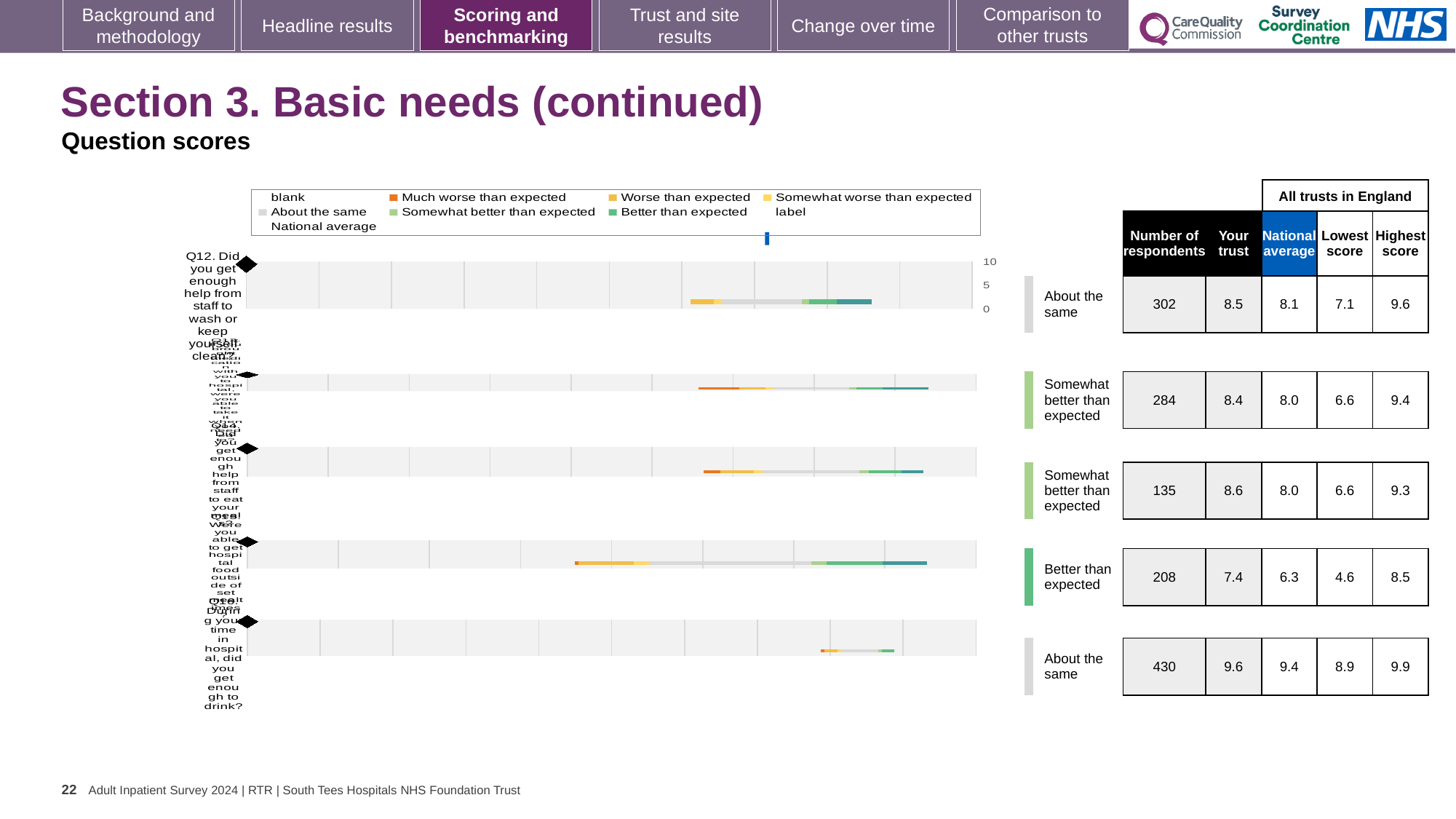
Which row has the lowest 'Your trust' score? the fourth row (Q15, hospital food outside of set meal times), 7.4 What kind of chart is used to show the question scores on this slide? bar chart How many question rows are plotted in the chart? 5 What is the 'Your trust' score for Q12 (help from staff to wash or keep yourself clean)? 8.5 Which row has the highest 'Your trust' score? the fifth row (Q16, enough to drink), 9.6 What is the highest score across all trusts in England for the fifth row (Q16)? 9.9 What colour does the legend use for 'Much worse than expected'? orange What is the national average for Q12 (help from staff to wash or keep yourself clean)? 8.1 For the fourth row (Q15), what is the difference between the 'Your trust' score and the national average? 1.1 How many respondents answered Q12 (help from staff to wash or keep yourself clean)? 302 For the first row (Q12), is the 'Your trust' score or the national average larger? Your trust (8.5) What benchmark category is shown for the fourth row (Q15)? Better than expected